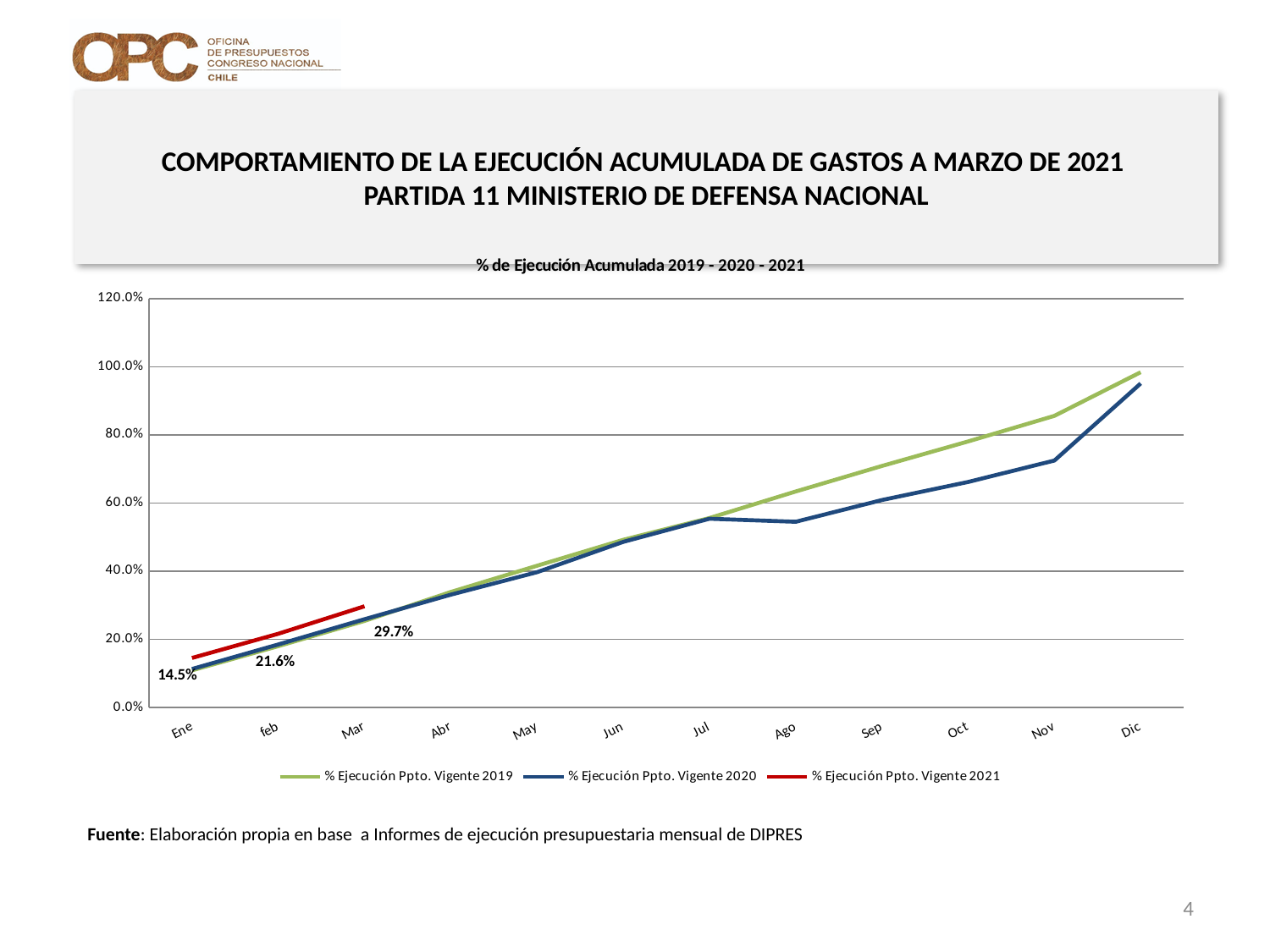
What kind of chart is shown on the slide? line chart Does the % Ejecución Ppto. Vigente 2019 line rise or fall from Ene to Dic? rise Is the value for % Ejecución Ppto. Vigente 2019 in Dic greater or less than 80.0%? greater What is the value of % Ejecución Ppto. Vigente 2021 in feb? 21.6% What is the value of % Ejecución Ppto. Vigente 2021 in Ene? 14.5% What is the title of the chart? % de Ejecución Acumulada 2019 - 2020 - 2021 How many months are shown on the x axis? 12 By how many percentage points did % Ejecución Ppto. Vigente 2021 increase from Ene to Mar? 15.2 What is the value of % Ejecución Ppto. Vigente 2021 in Mar? 29.7% How many series does the chart legend list? 3 Is the value for % Ejecución Ppto. Vigente 2020 in Ago greater or less than 60.0%? less In Nov, which series has the higher value: % Ejecución Ppto. Vigente 2019 or % Ejecución Ppto. Vigente 2020? % Ejecución Ppto. Vigente 2019